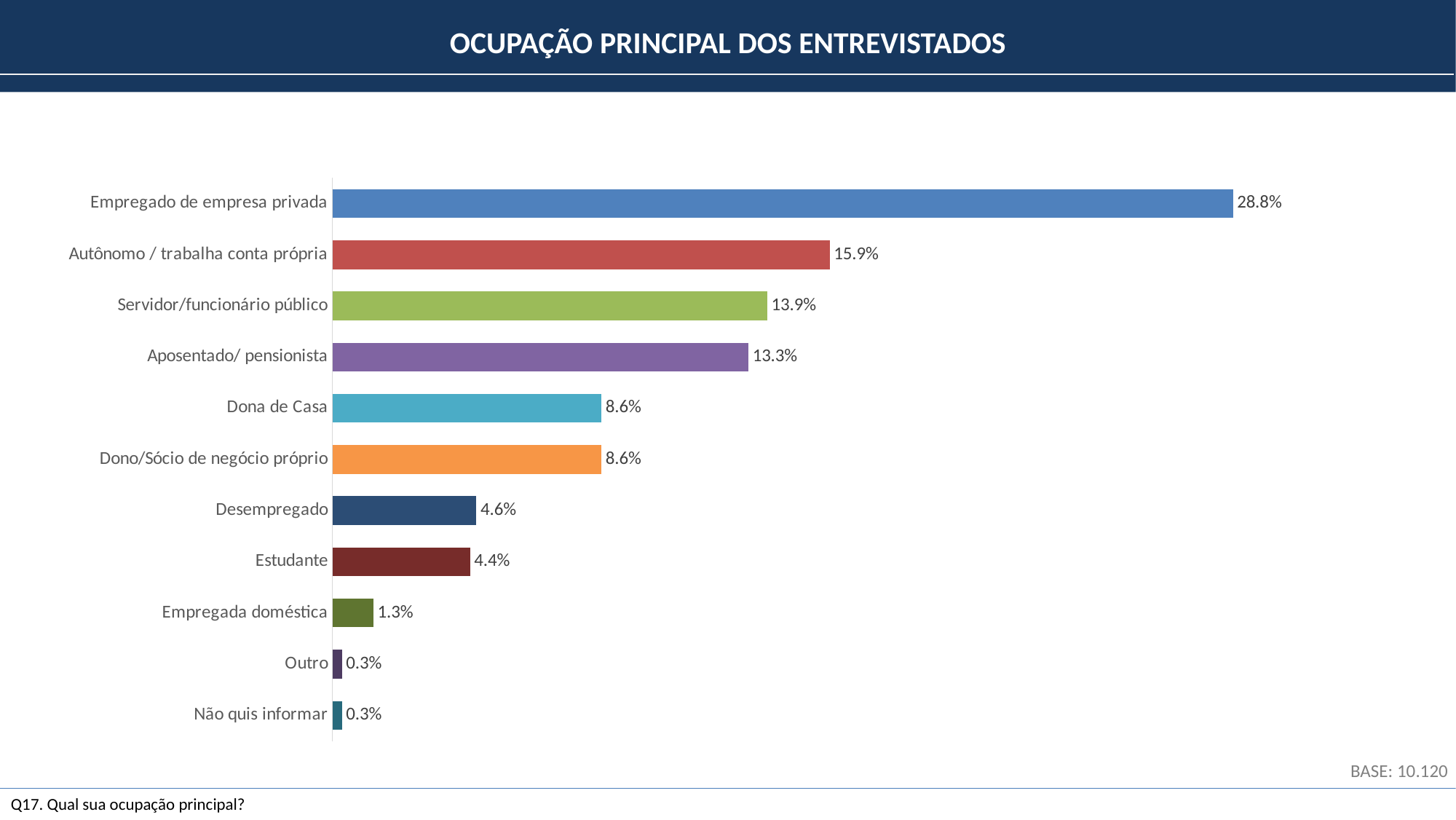
What kind of chart is shown on the slide? Bar chart What is the value for Empregada doméstica? 1.3% Which category has the highest value? Empregado de empresa privada Which is larger, Desempregado or Empregada doméstica? Desempregado What is the difference between Empregado de empresa privada and Autônomo / trabalha conta própria? 12.9% What is the difference between Autônomo / trabalha conta própria and Servidor/funcionário público? 2.0% What is the value for Estudante? 4.4% What is the title of the chart? OCUPAÇÃO PRINCIPAL DOS ENTREVISTADOS What is the value for Aposentado/ pensionista? 13.3% What is the value for Empregado de empresa privada? 28.8% Which is larger, Servidor/funcionário público or Dona de Casa? Servidor/funcionário público How many categories are shown in the chart? 11